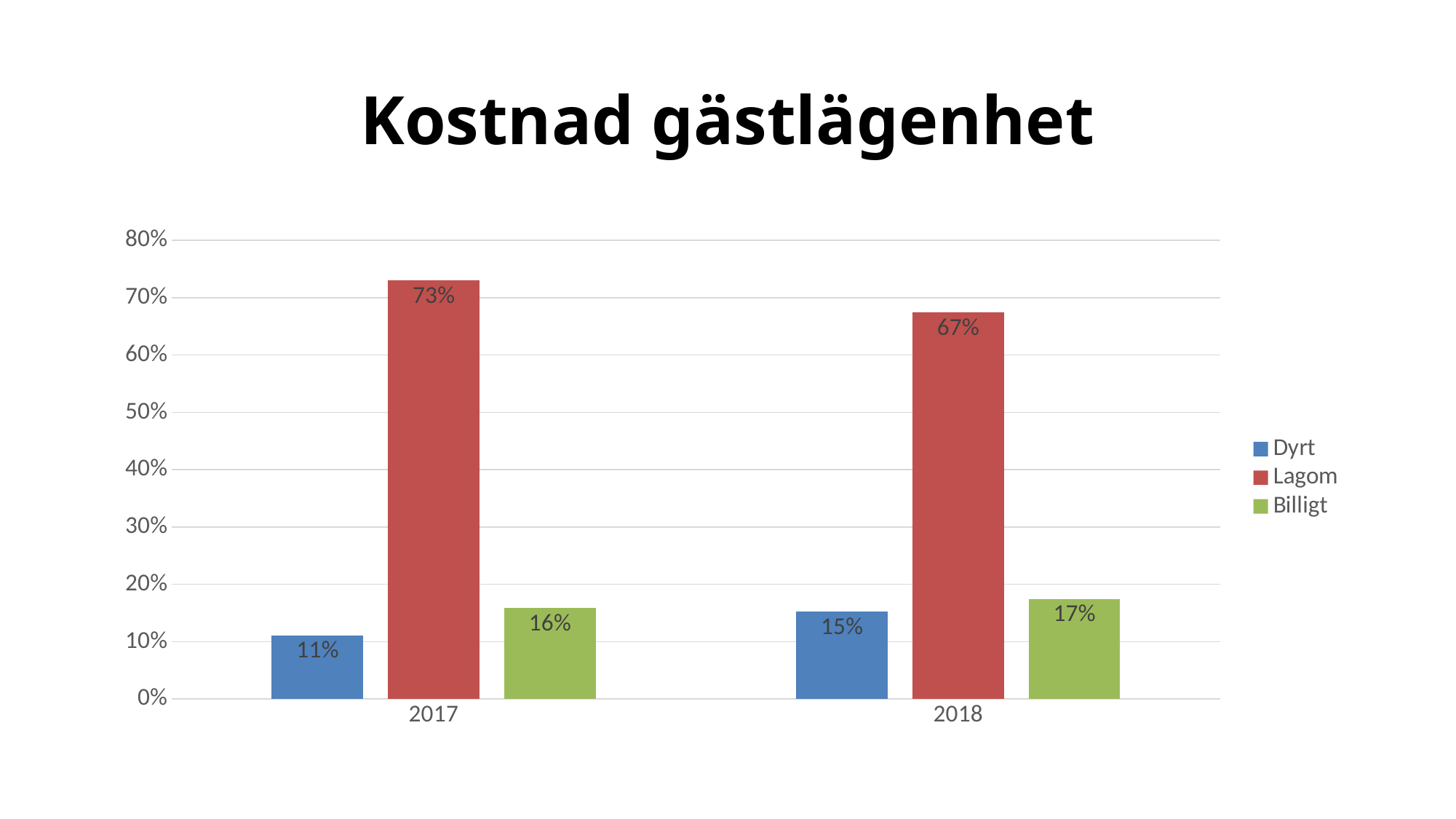
What kind of chart is shown? Bar chart Which series has the lowest value in 2017? Dyrt Which series has the highest value in 2018? Lagom What is the difference between the Lagom values for 2017 and 2018? 6% How many series does the legend list? 3 Which is larger, Dyrt in 2017 or Dyrt in 2018? Dyrt in 2018 How many years are shown on the x axis? 2 What is the value for Dyrt in 2018? 15% What is the value for Billigt in 2017? 16% What is the title of the chart? Kostnad gästlägenhet Is the value for Lagom in 2018 greater or less than 60%? greater What is the value for Lagom in 2017? 73%